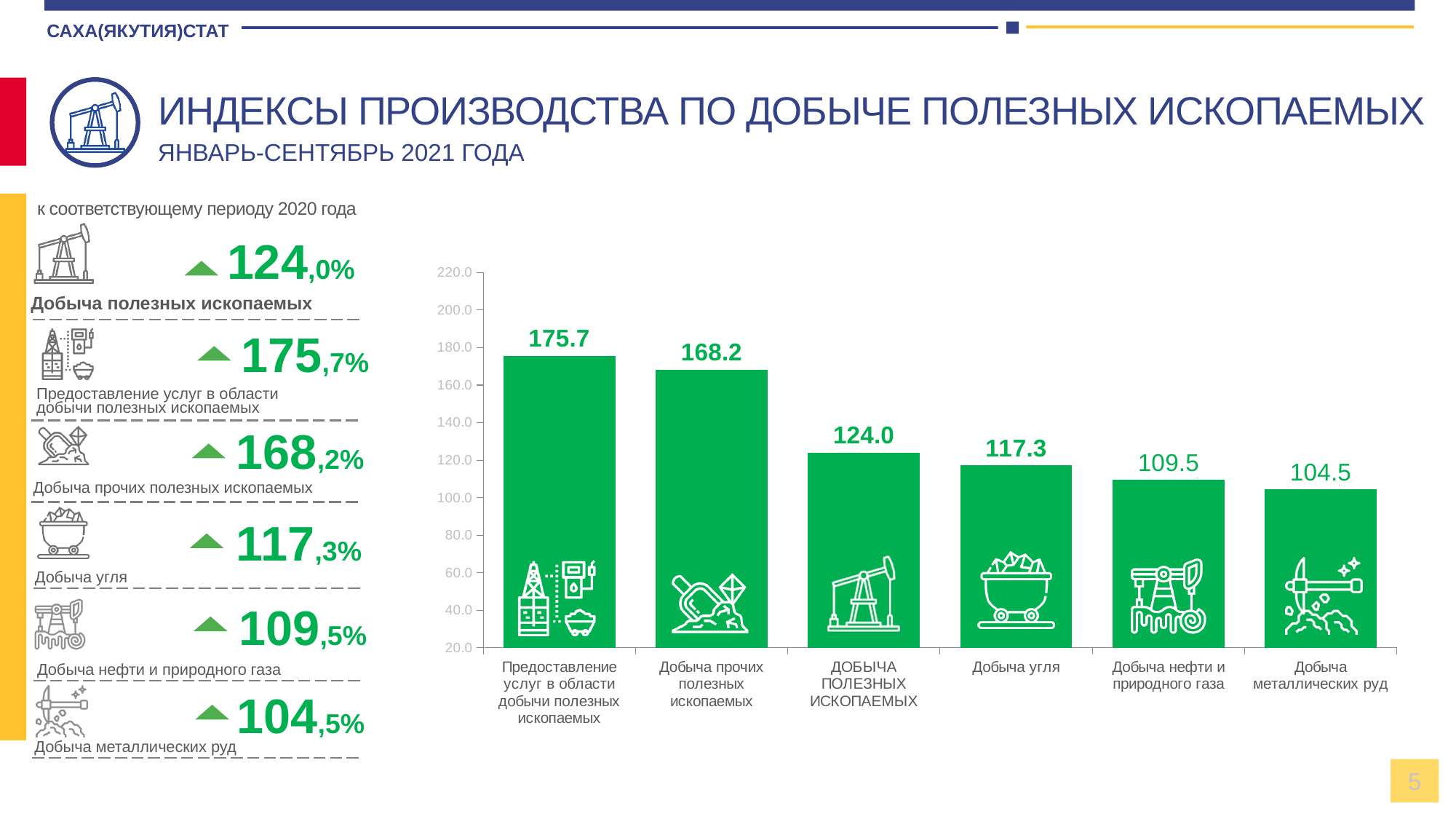
Do the bar values rise or fall from left to right along the x axis? fall What is the value for "Добыча металлических руд" in the chart? 104.5 What is the value for "Добыча нефти и природного газа" in the chart? 109.5 Which is larger: the value for "ДОБЫЧА ПОЛЕЗНЫХ ИСКОПАЕМЫХ" or the value for "Добыча угля"? ДОБЫЧА ПОЛЕЗНЫХ ИСКОПАЕМЫХ What colour are the bars in the chart? green What type of chart is shown on the slide? bar chart Which category has the lowest value in the chart? Добыча металлических руд Which category has the highest value in the chart? Предоставление услуг в области добычи полезных ископаемых What is the difference between the values for "Предоставление услуг в области добычи полезных ископаемых" and "Добыча прочих полезных ископаемых"? 7.5 What is the value for "Добыча прочих полезных ископаемых" in the chart? 168.2 How many categories (bars) does the chart show? 6 What is the value for "Добыча угля" in the chart? 117.3